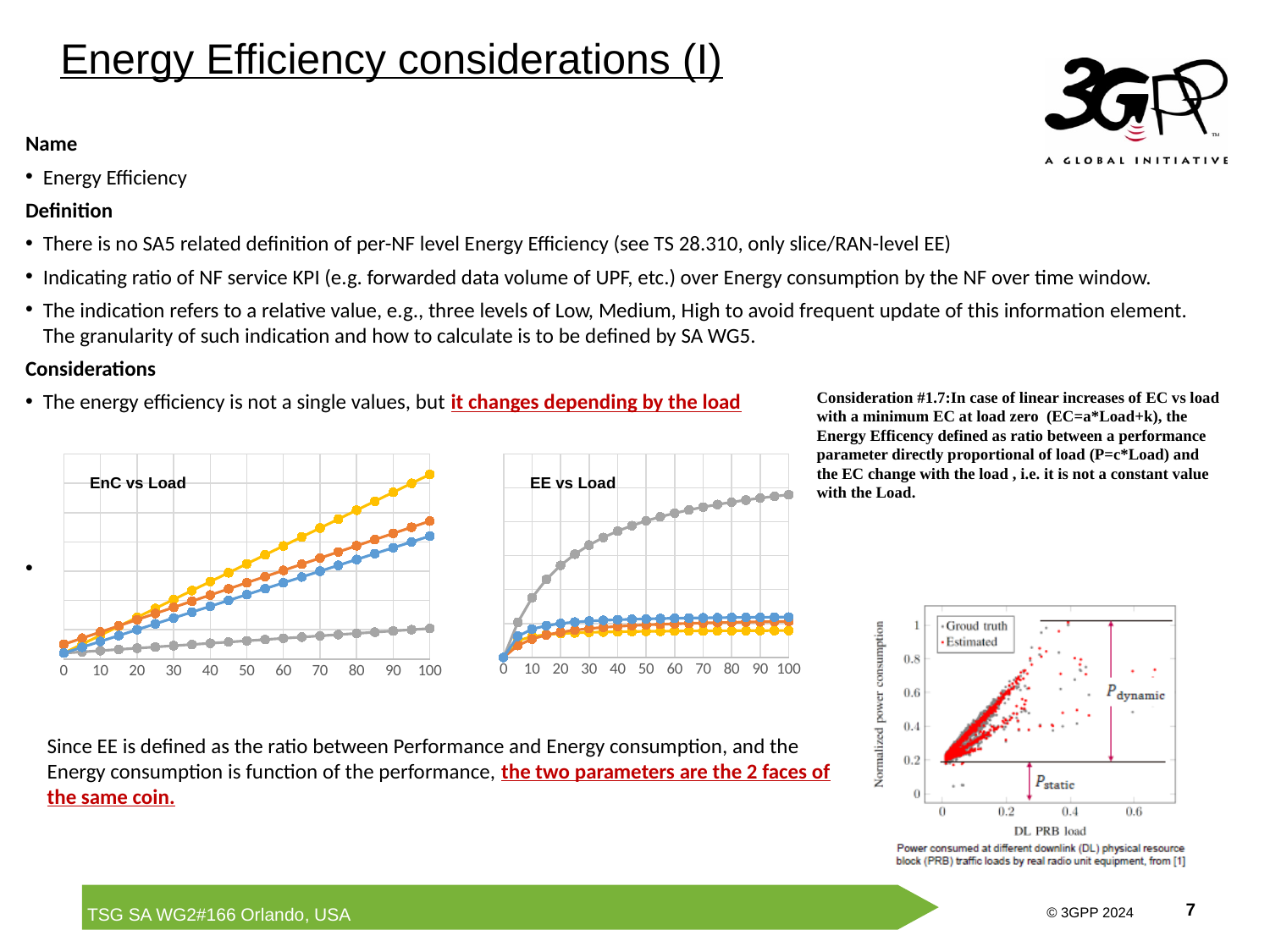
What kind of chart is the "EE vs Load" chart? Line chart In the "EE vs Load" chart, how many lines are plotted? 4 In the "EnC vs Load" chart, which coloured line is highest at load 100? Yellow What is the title of the left chart? EnC vs Load In the "EnC vs Load" chart, what is the highest value shown on the x axis? 100 In the "EnC vs Load" chart, which coloured line is lowest at load 100? Gray In the "EnC vs Load" chart, how many lines are plotted? 4 In the "EE vs Load" chart, at load 100, is the gray line higher or lower than the blue line? Higher In the "EE vs Load" chart, which coloured line is highest at load 100? Gray In the "EnC vs Load" chart, do the lines rise or fall as load increases from 0 to 100? Rise What is the title of the right chart? EE vs Load What kind of chart is the "EnC vs Load" chart? Line chart